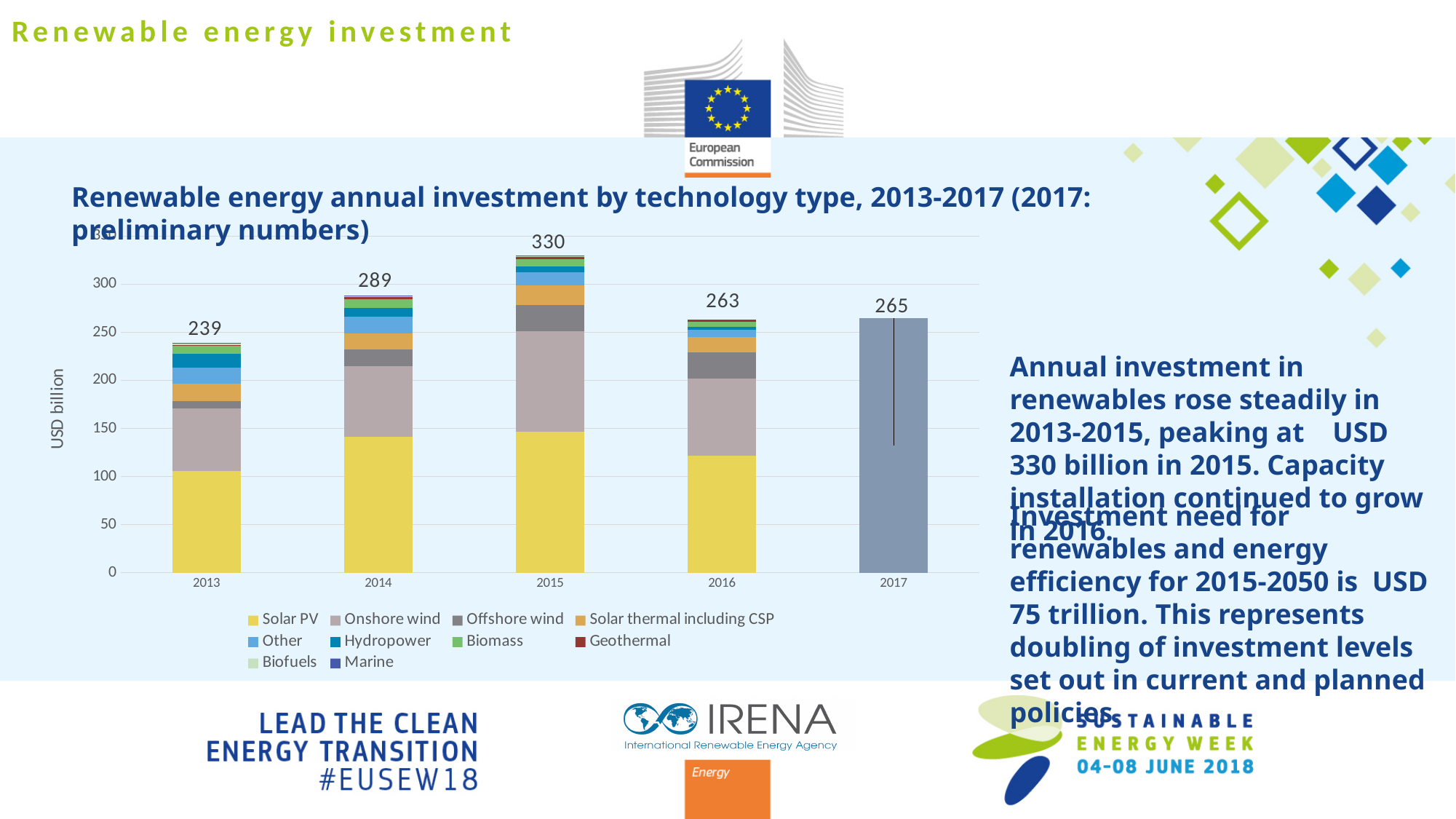
Which year has a larger total investment, 2014 or 2016? 2014 Which year has the highest total annual investment? 2015 How many technology types does the legend list? 10 What is the total investment value labelled above the 2013 bar? 239 Which year has the lowest total annual investment? 2013 What is the total investment value labelled for 2017? 265 What is the total renewable energy investment shown for 2015? 330 How many years are shown on the x axis of the chart? 5 What is the difference between the total investment in 2014 and in 2016? 26 Is the Solar PV value for 2013 greater or less than 150? less What is the difference between the total investment in 2015 and in 2013? 91 What kind of chart is used to show the annual investment by technology type? Stacked bar chart